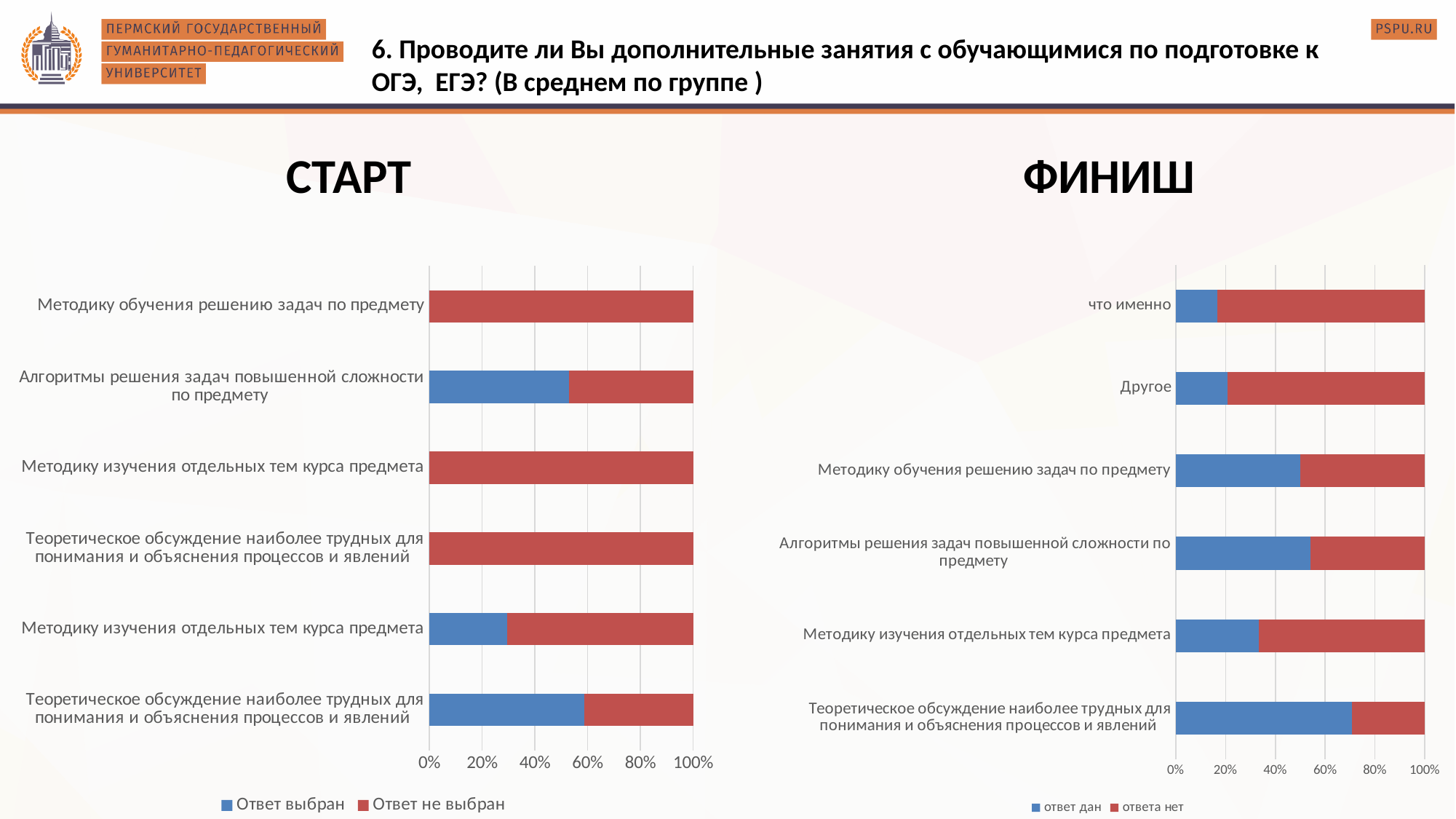
In the СТАРТ chart, which colour represents 'Ответ не выбран'? red In the ФИНИШ chart, which has the larger 'ответ дан' share: 'Другое' or 'Методику обучения решению задач по предмету'? Методику обучения решению задач по предмету How many categories does the ФИНИШ chart on the right show? 6 How many series does the legend of the СТАРТ chart list? 2 In the ФИНИШ chart, which category has the largest 'ответ дан' share? Теоретическое обсуждение наиболее трудных для понимания и объяснения процессов и явлений In the ФИНИШ chart, is the 'ответ дан' value for 'Теоретическое обсуждение наиболее трудных для понимания и объяснения процессов и явлений' greater or less than 60%? greater What kind of chart is the СТАРТ chart on the left? bar chart What are the two legend entries of the ФИНИШ chart? ответ дан, ответа нет In the ФИНИШ chart, is the 'ответ дан' value for 'что именно' greater or less than 40%? less In the ФИНИШ chart, is the 'ответ дан' value for 'Методику изучения отдельных тем курса предмета' greater or less than 40%? less How many series does the legend of the ФИНИШ chart list? 2